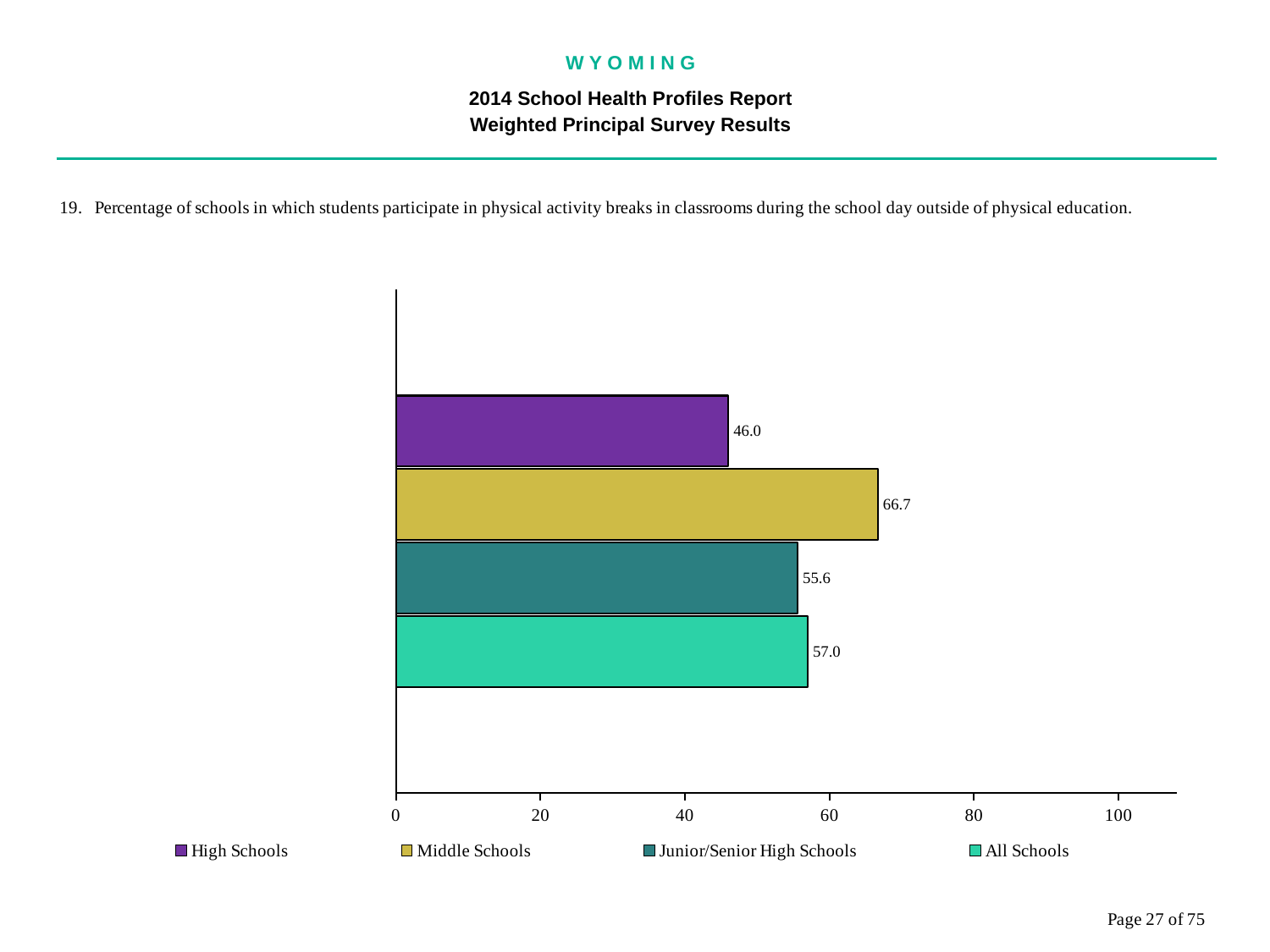
Is the value for Middle Schools greater or less than 60? greater What is the value for Junior/Senior High Schools? 55.6 What is the value for Middle Schools? 66.7 Which school type has the lowest value? High Schools How many bars are plotted in the chart? 4 What is the difference between the values for Middle Schools and High Schools? 20.7 How many entries does the legend list? 4 What is the value for All Schools? 57.0 What kind of chart is shown on the slide? bar chart Which school type has the highest value? Middle Schools What is the value for High Schools? 46.0 Which is larger, the value for All Schools or the value for Junior/Senior High Schools? All Schools